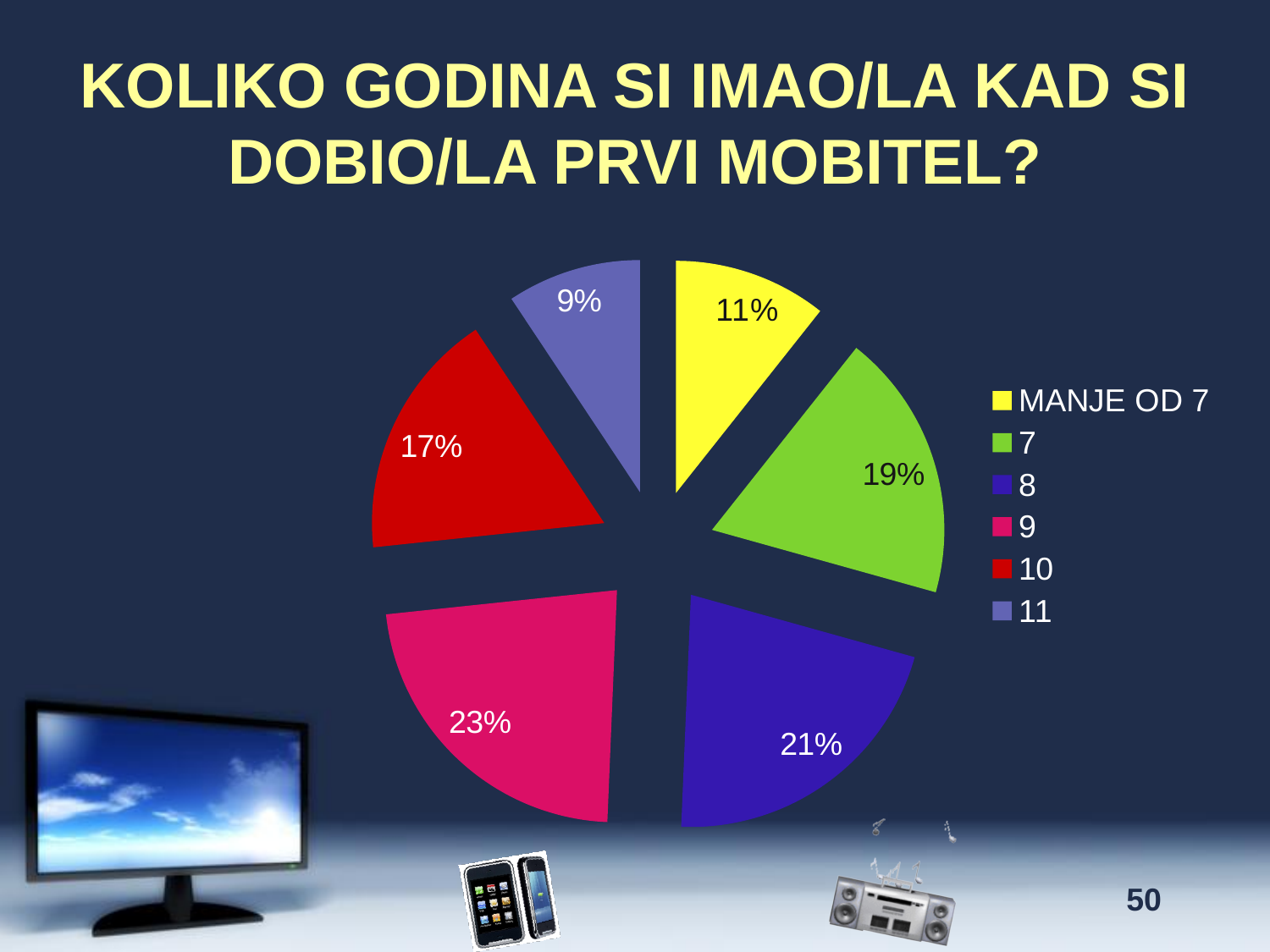
What is the value for the category "11"? 9% Which is larger, the value for "7" or the value for "10"? 7 What is the title of the chart? KOLIKO GODINA SI IMAO/LA KAD SI DOBIO/LA PRVI MOBITEL? What is the value for the category "MANJE OD 7"? 11% What share of the pie does the category "9" have? 23% What is the value for the category "7"? 19% Which category has the smallest slice? 11 What colour is the slice for the category "10"? red How many categories does the pie chart have? 6 What is the difference between the values for "8" and "10"? 4% What kind of chart is shown on the slide? pie chart Which category has the largest slice? 9